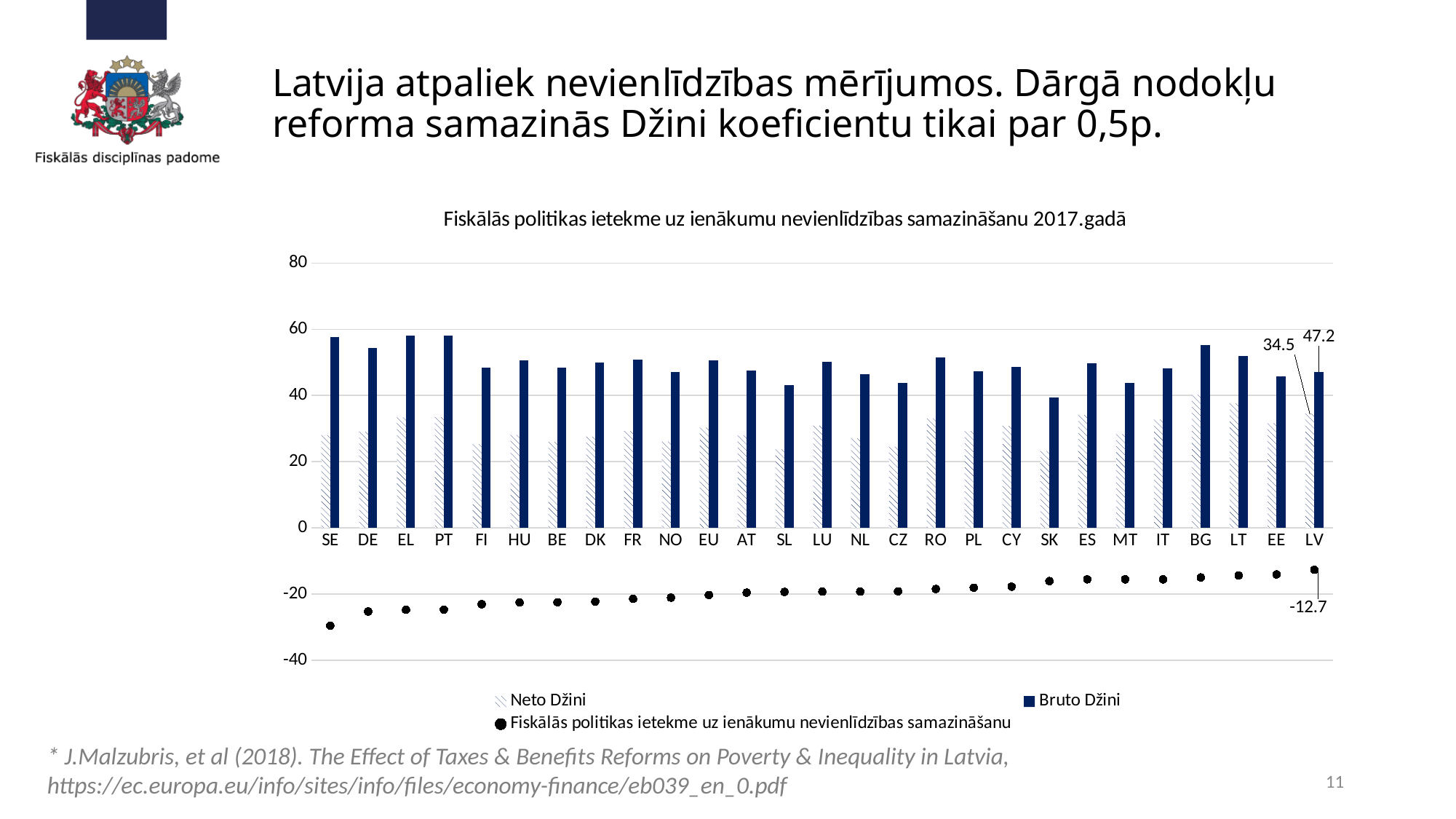
What is the difference between the Bruto Džini and Neto Džini values for LV? 12.7 What is the Neto Džini value for LV? 34.5 What is the Bruto Džini value for LV? 47.2 How many series does the legend list? 3 Which category has the lowest Bruto Džini value? SK What is the value of 'Fiskālās politikas ietekme uz ienākumu nevienlīdzības samazināšanu' for LV? -12.7 How many countries/categories are shown on the x axis? 27 What is the title of the chart? Fiskālās politikas ietekme uz ienākumu nevienlīdzības samazināšanu 2017.gadā Do the values of the fiscal policy impact dot series rise or fall from left to right along the x axis? rise Which has the larger Bruto Džini value, SE or SK? SE Which category has the lowest (most negative) value for the fiscal policy impact dot series? SE